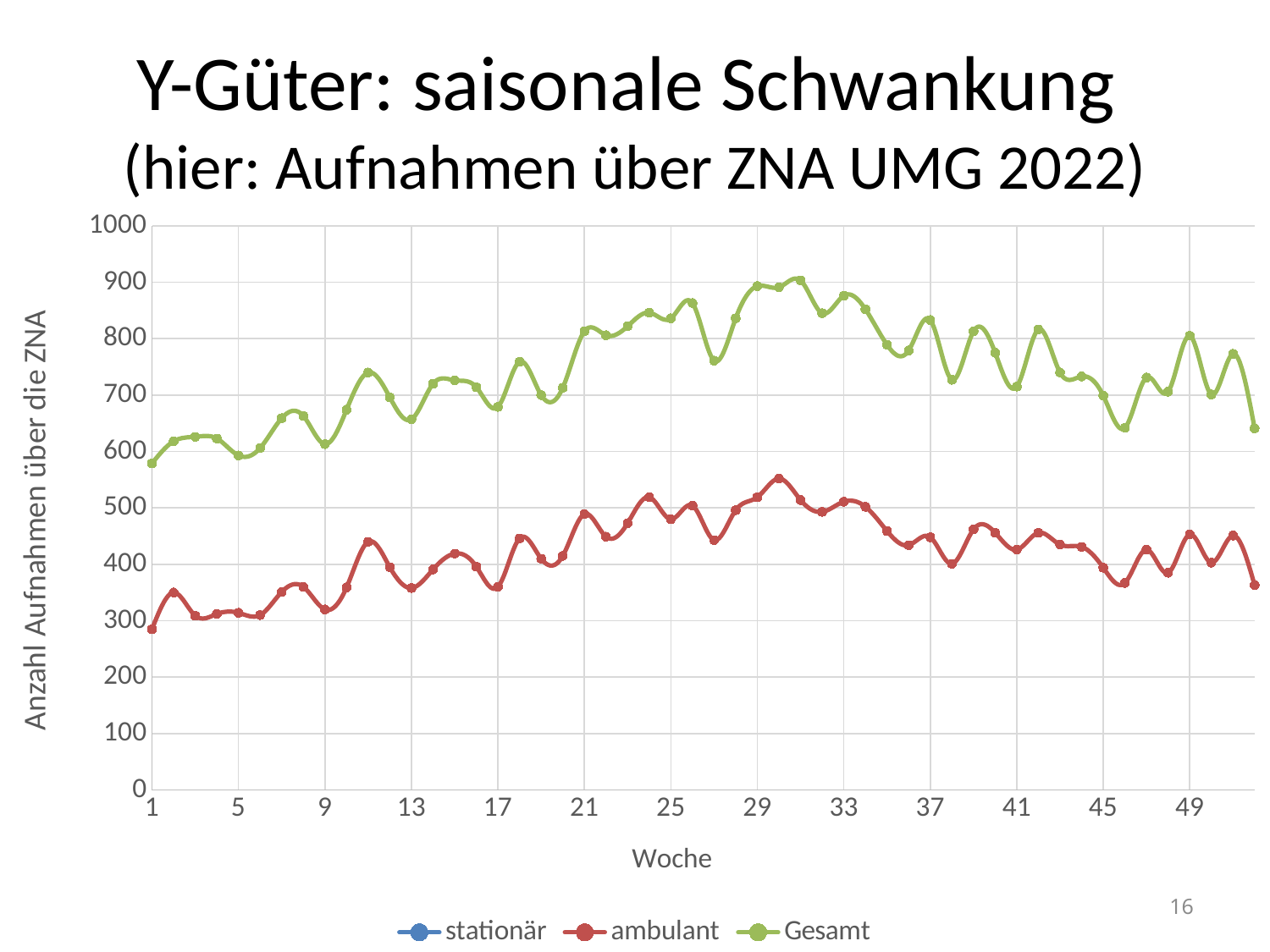
What is the label of the x axis? Woche Which series has the highest values across the chart? Gesamt Is the Gesamt value at week 1 greater or less than 600? less Which series are listed in the legend? stationär, ambulant, Gesamt Is the Gesamt value at week 46 greater or less than 600? greater Does the Gesamt series generally rise or fall from week 1 to week 29? rise What kind of chart is shown on the slide? line chart Is the ambulant value at week 30 greater or less than 500? greater How many series does the legend list? 3 At week 25, which series has the larger value, ambulant or Gesamt? Gesamt